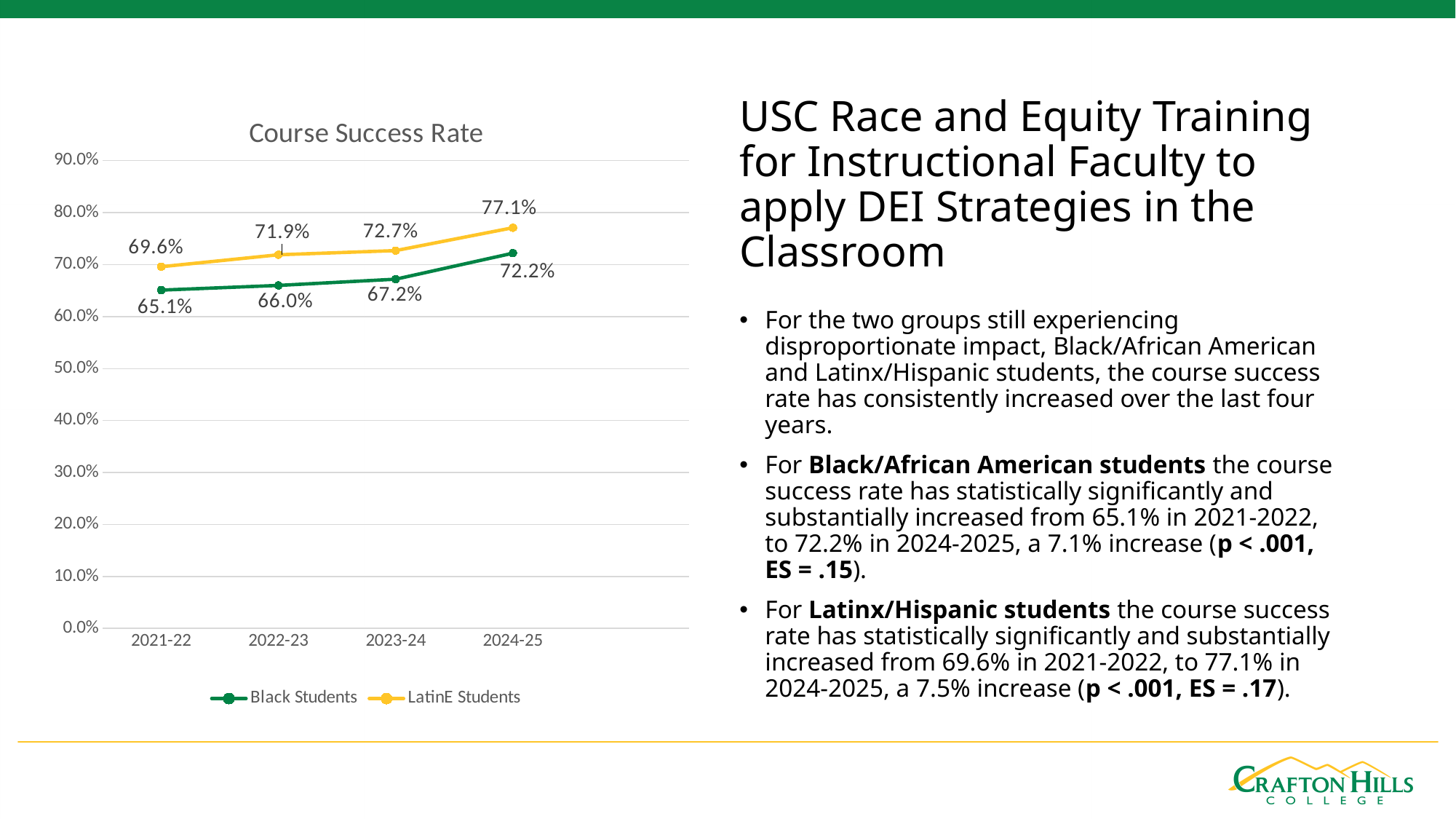
What is the course success rate for LatinE Students in 2024-25? 77.1% How many years are shown on the x axis of the chart? 4 In which year is the course success rate for Black Students highest? 2024-25 What is the course success rate for Black Students in 2021-22? 65.1% How many series does the chart legend list? 2 In which year is the course success rate for LatinE Students lowest? 2021-22 What kind of chart is shown on the slide? Line chart What is the course success rate for Black Students in 2023-24? 67.2% Do the course success rates for Black Students rise or fall from 2021-22 to 2024-25? Rise Which group has the higher course success rate in 2022-23, Black Students or LatinE Students? LatinE Students What is the course success rate for LatinE Students in 2022-23? 71.9% What is the difference between the LatinE Students and Black Students course success rates in 2024-25? 4.9%